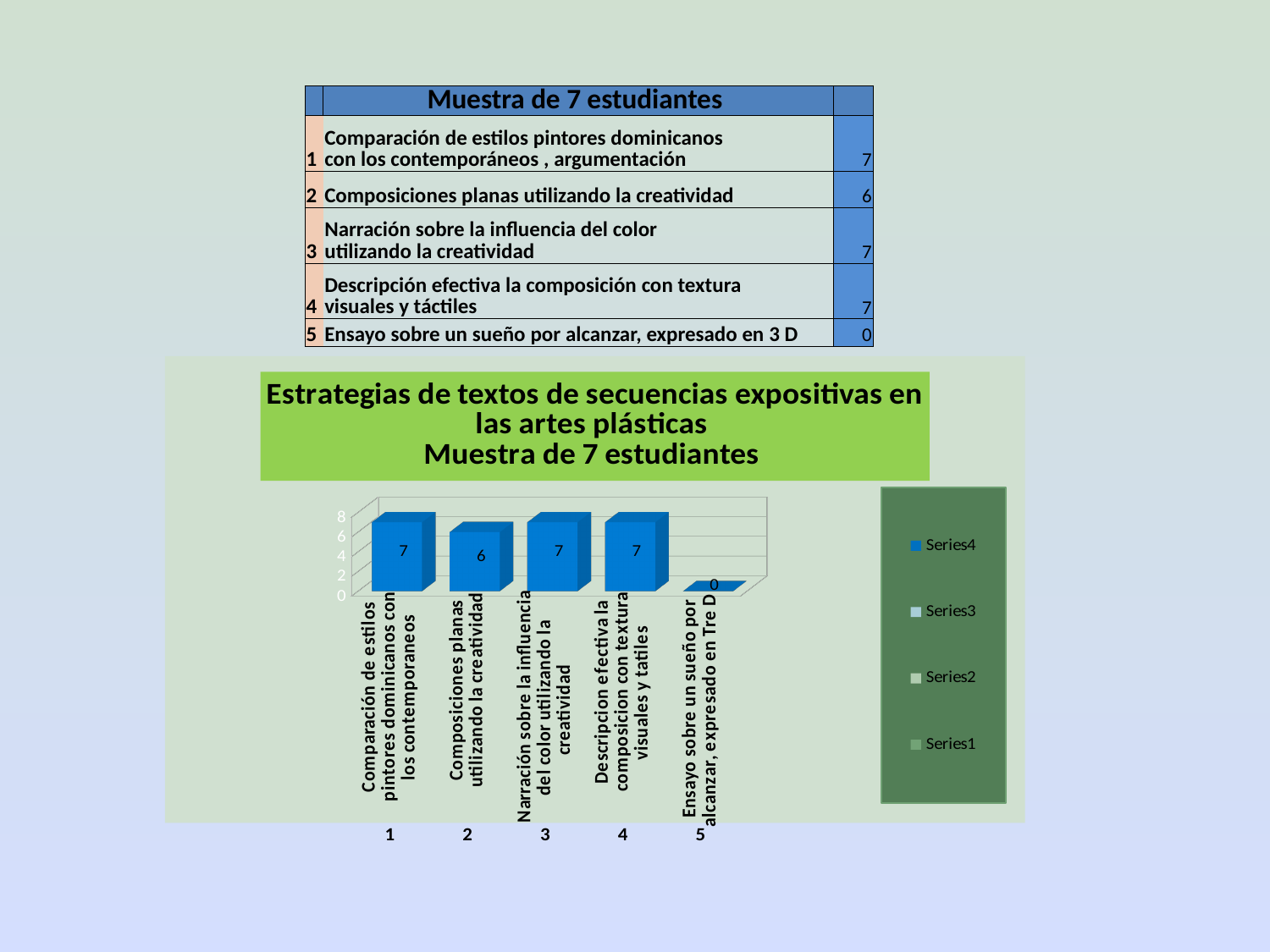
What type of chart is shown on the slide? bar chart Which category has the lowest value in the chart? Ensayo sobre un sueño por alcanzar, expresado en Tre D What is the value for "Composiciones planas utilizando la creatividad" in the chart? 6 How many categories in the chart have a value of 7? 3 How many categories are plotted in the chart? 5 How many series does the chart legend list? 4 What is the value for "Ensayo sobre un sueño por alcanzar, expresado en Tre D" in the chart? 0 What is the difference between the value for "Comparación de estilos pintores dominicanos con los contemporaneos" and the value for "Composiciones planas utilizando la creatividad"? 1 What is the highest value shown on the chart's vertical axis? 8 What is the title of the chart? Estrategias de textos de secuencias expositivas en las artes plásticas Muestra de 7 estudiantes Which is larger: the value for "Descripcion efectiva la composicion con textura visuales y tatiles" or the value for "Composiciones planas utilizando la creatividad"? Descripcion efectiva la composicion con textura visuales y tatiles What is the value for "Narración sobre la influencia del color utilizando la creatividad" in the chart? 7